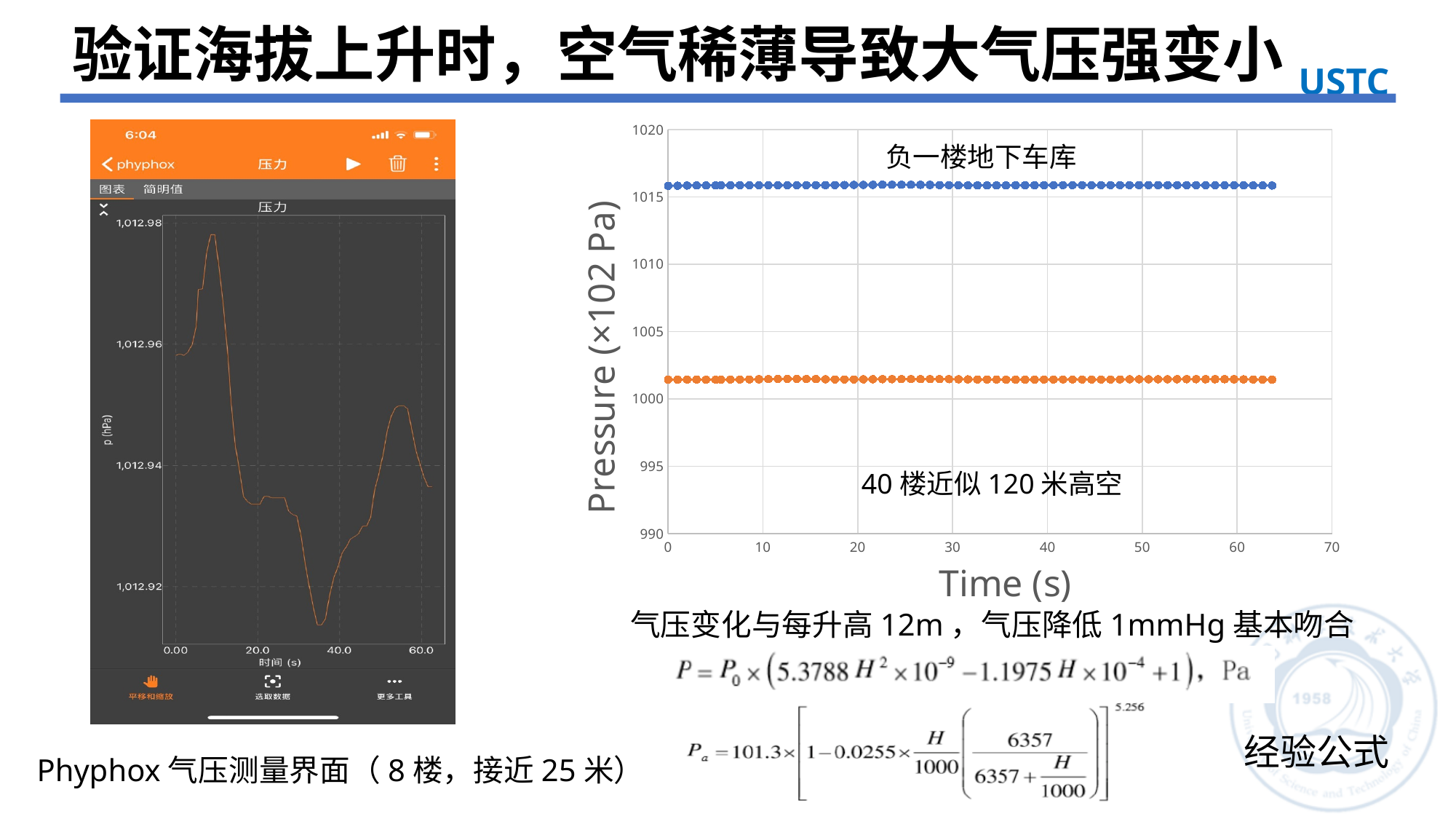
In the right-hand chart, is the pressure for 40 楼近似 120 米高空 greater or less than 1000? greater In the right-hand chart, is the pressure for 负一楼地下车库 greater or less than 1010? greater In the right-hand chart, is the pressure for 40 楼近似 120 米高空 greater or less than 1005? less What kind of chart is the right-hand chart with the Time (s) axis? scatter chart What kind of chart is shown in the Phyphox screenshot on the left? line chart In the right-hand chart, does the pressure for 负一楼地下车库 rise, fall, or stay flat over time? stay flat In the right-hand chart, what colour are the points for 负一楼地下车库? blue In the right-hand chart, what is the y-axis title? Pressure (×102 Pa) In the right-hand chart, how many data series are plotted? 2 In the right-hand chart, which series has the higher pressure, 负一楼地下车库 or 40 楼近似 120 米高空? 负一楼地下车库